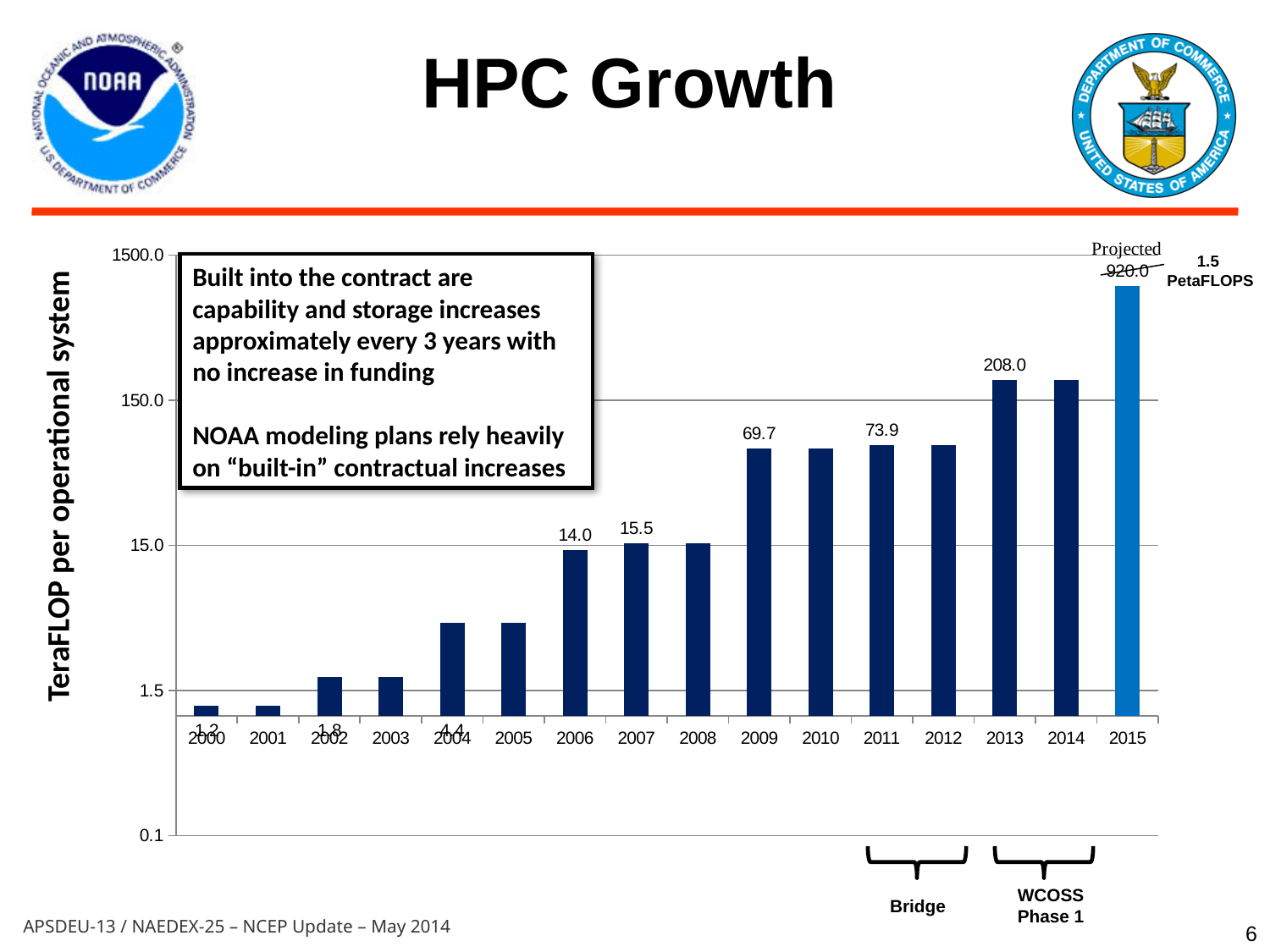
What is the label on the y axis? TeraFLOP per operational system What is the value for 2007? 15.5 Which year has the highest bar? 2015 How many years are shown on the x axis? 16 What is the value for 2011? 73.9 What is the value for 2009? 69.7 What is the value for 2013? 208.0 What is the value for 2006? 14.0 Which is larger, the value for 2011 or the value for 2009? 2011 Is the value for 2014 greater or less than 150.0? greater What is the difference between the values for 2013 and 2011? 134.1 What type of chart is shown on the slide? bar chart